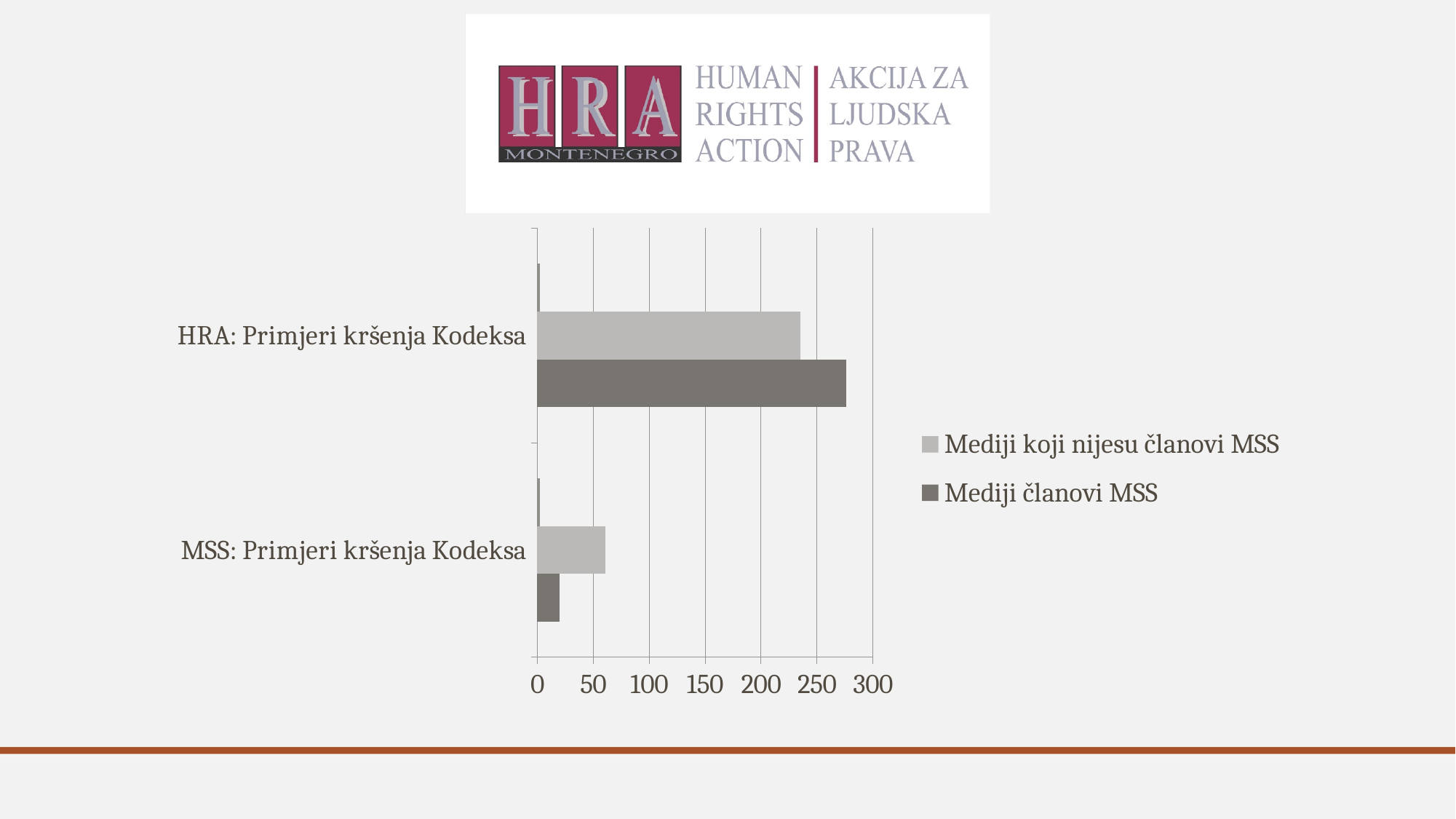
How many series does the chart legend list? 2 In the 'MSS: Primjeri kršenja Kodeksa' category, which series has the larger value? Mediji koji nijesu članovi MSS Is the value for 'Mediji koji nijesu članovi MSS' in the 'MSS: Primjeri kršenja Kodeksa' category greater or less than 50? greater In the 'HRA: Primjeri kršenja Kodeksa' category, which series has the larger value? Mediji članovi MSS Which category has the highest value for the 'Mediji članovi MSS' series? HRA: Primjeri kršenja Kodeksa Is the value for 'Mediji članovi MSS' in the 'HRA: Primjeri kršenja Kodeksa' category greater or less than 250? greater Which series is shown in the lighter grey colour in the legend? Mediji koji nijesu članovi MSS What is the highest tick value shown on the horizontal axis? 300 How many categories are shown on the vertical axis of the chart? 2 Is the value for 'Mediji koji nijesu članovi MSS' in the 'HRA: Primjeri kršenja Kodeksa' category greater or less than 250? less What kind of chart is shown on the slide? bar chart